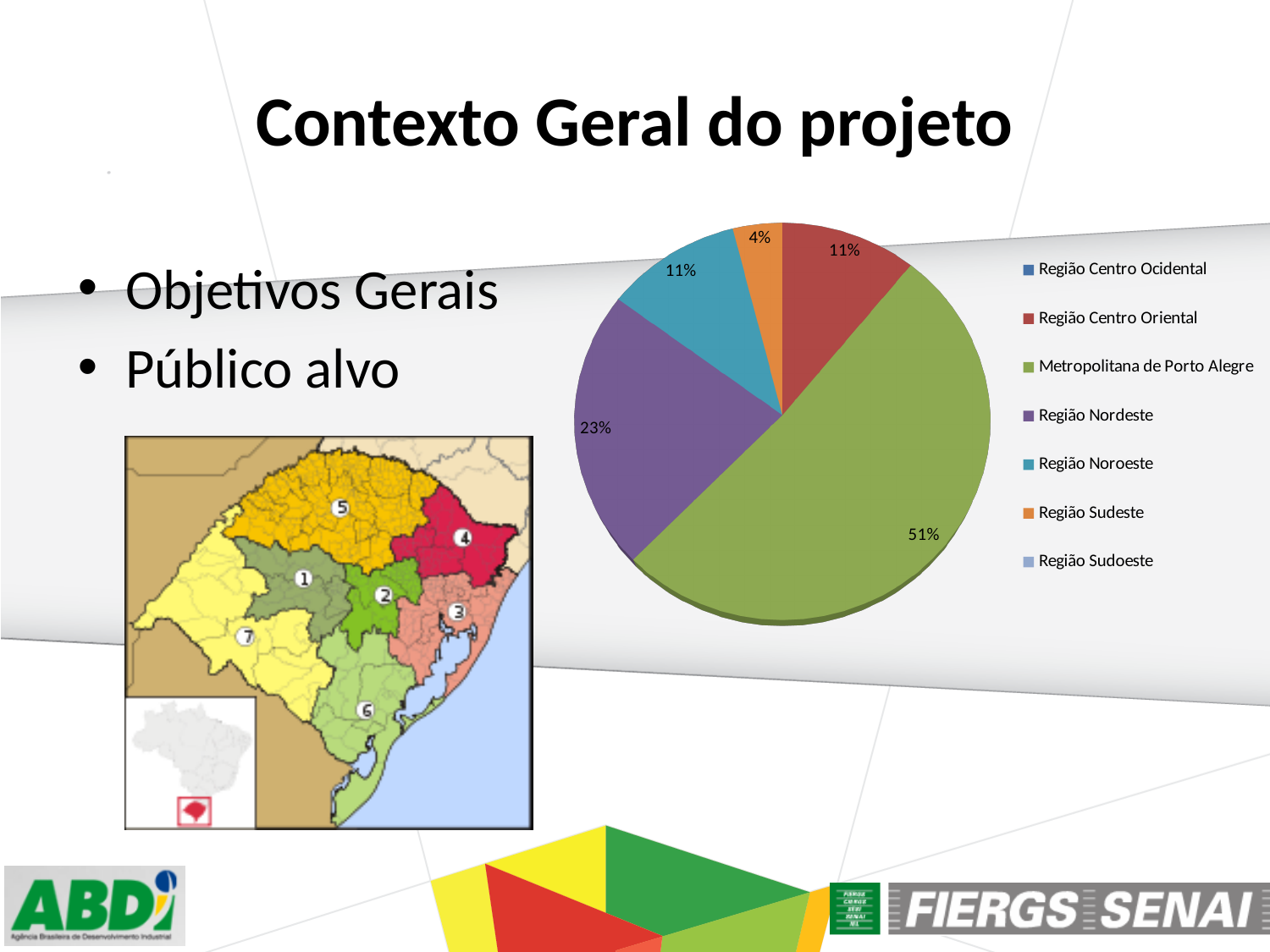
How many entries does the pie chart's legend list? 7 What type of chart is shown on the slide? pie chart What percentage does the pie chart show for Região Sudeste? 4% What colour is the Região Nordeste slice in the pie chart? purple What percentage does the pie chart show for Região Noroeste? 11% What is the difference in percentage points between Metropolitana de Porto Alegre and Região Nordeste? 28 What percentage does the pie chart show for Metropolitana de Porto Alegre? 51% Among the slices with a percentage label, which region has the smallest slice? Região Sudeste Which slice is larger, Região Nordeste or Região Noroeste? Região Nordeste Which region has the largest slice in the pie chart? Metropolitana de Porto Alegre What percentage does the pie chart show for Região Centro Oriental? 11% What percentage does the pie chart show for Região Nordeste? 23%